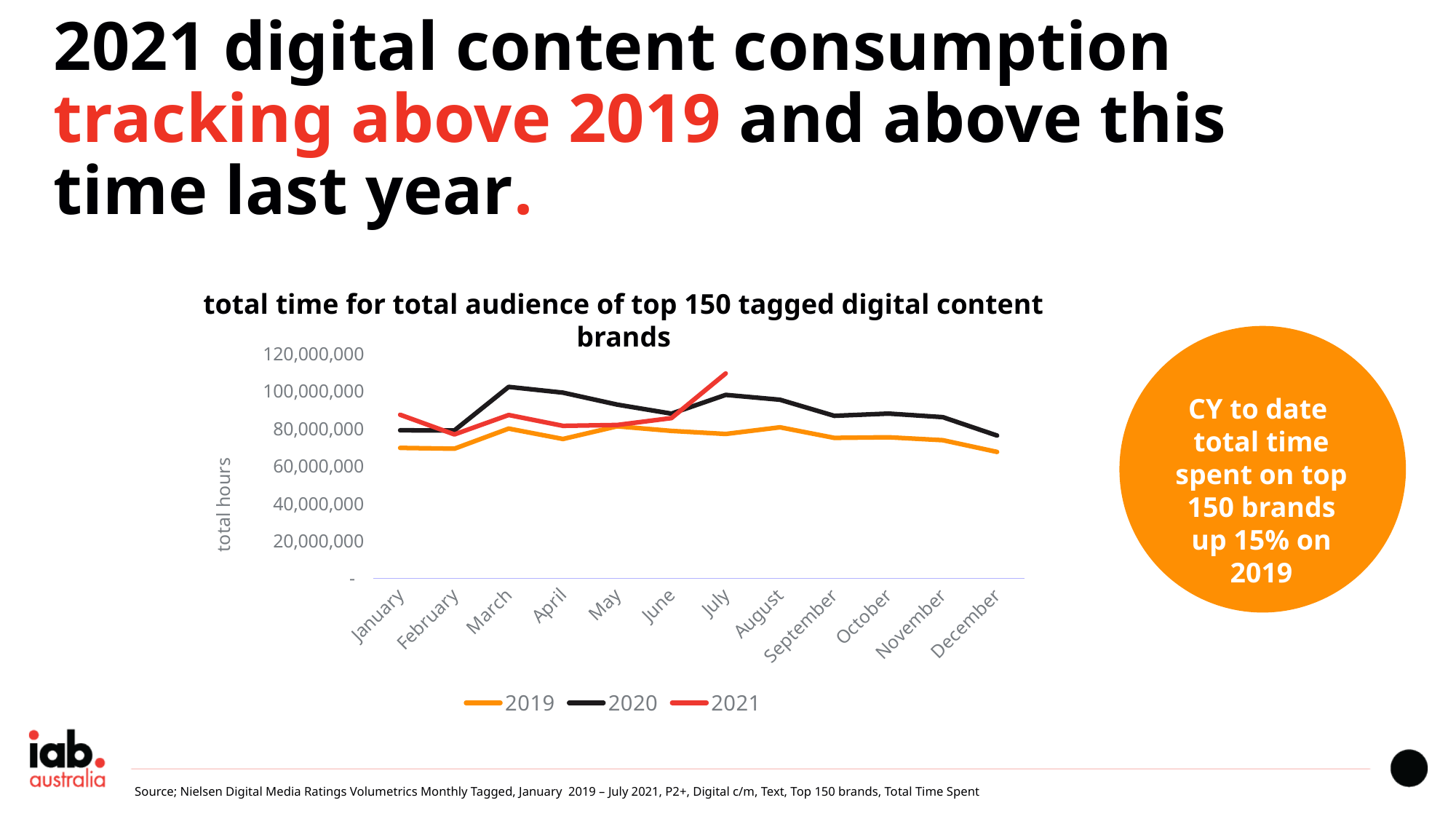
Does the 2021 series rise or fall from June to July? rise In July, which series has the larger value, 2020 or 2021? 2021 What is the label on the y axis of the chart? total hours What kind of chart is shown on the slide? line chart Which month has the highest value for the 2021 series? July In March, which series has the larger value, 2019 or 2020? 2020 What colour is the line for the 2021 series? red Is the 2021 value for July greater or less than 100,000,000? greater How many series does the chart legend list? 3 Is the 2020 value for March greater or less than 80,000,000? greater Is the 2019 value for December greater or less than 80,000,000? less How many months are shown along the x axis of the chart? 12